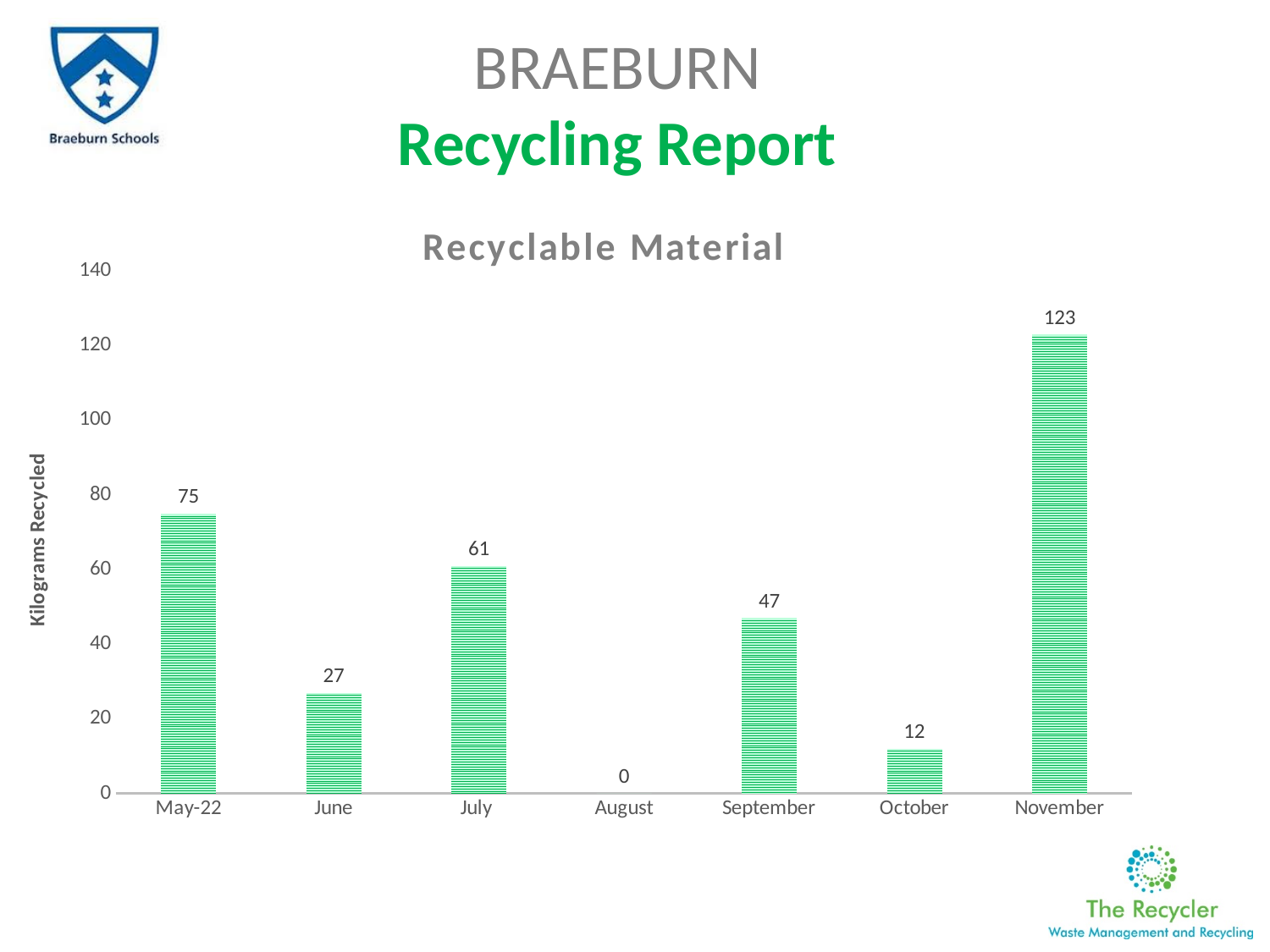
What is the value for November? 123 What kind of chart is shown on the slide? bar chart How many months are shown on the x axis? 7 Which is larger, the value for July or the value for September? July Is the value for October greater or less than 20? less What is the title of the chart? Recyclable Material Which month has the lowest value? August What is the difference between the values for November and May-22? 48 What is the difference between the values for July and September? 14 What is the value for June? 27 Which month has the highest value? November What is the value for August? 0